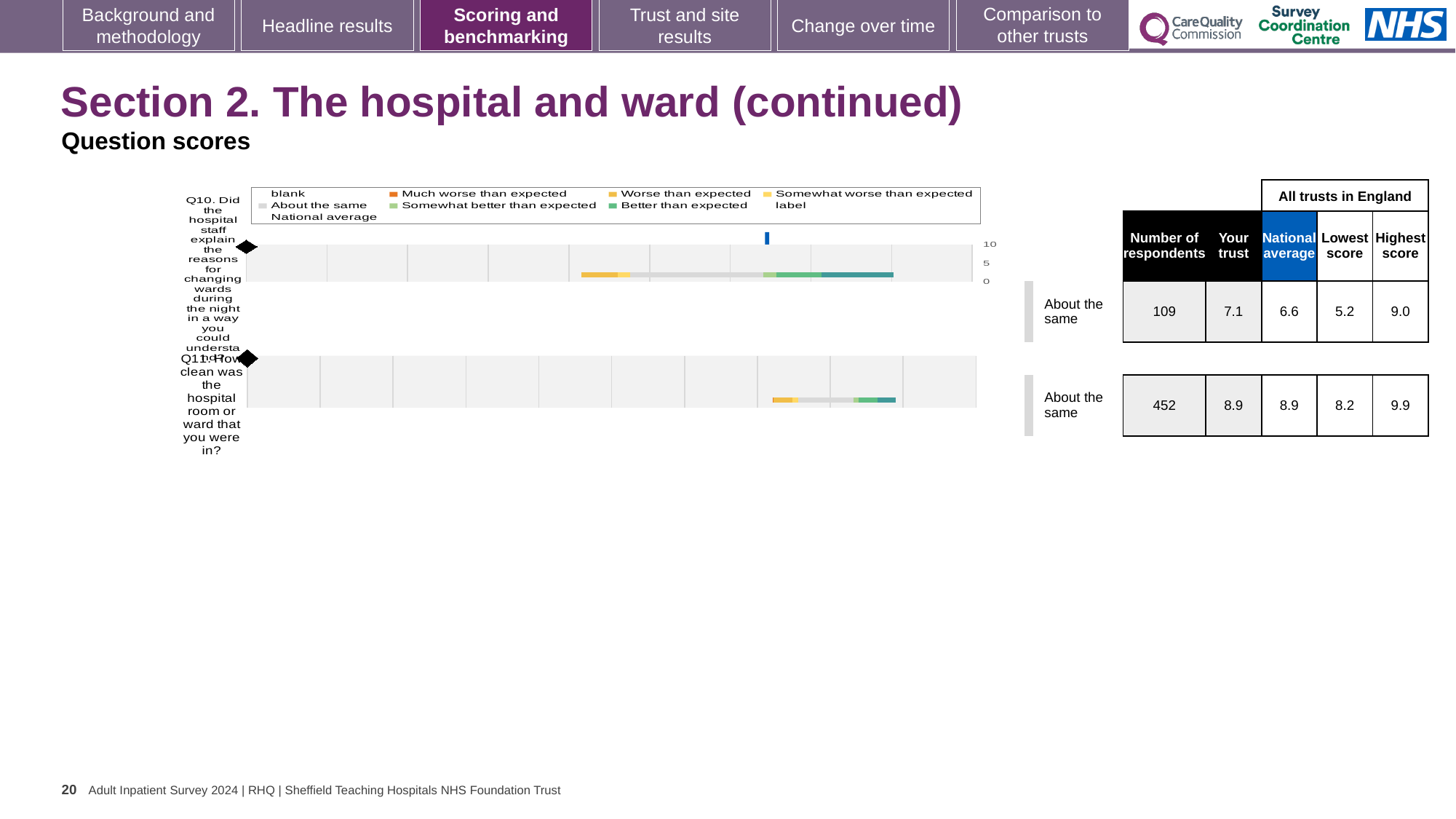
What kind of chart is used to show the question scores for Q10 and Q11? bar chart How many questions are plotted on the slide? 2 What is the difference between the highest and lowest scores for Q11? 1.7 What is the 'Your trust' score for Q10 (explaining reasons for changing wards during the night)? 7.1 What is the lowest score among all trusts in England for Q10? 5.2 For Q10, which is larger: the 'Your trust' score or the national average? Your trust How many respondents answered Q11 (how clean was the hospital room or ward)? 452 What is the national average score for Q10? 6.6 What is the difference between the 'Your trust' score and the national average for Q10? 0.5 Which question had more respondents, Q10 or Q11? Q11 What is the highest score among all trusts in England for Q11? 9.9 What benchmark category is shown for Q11? About the same